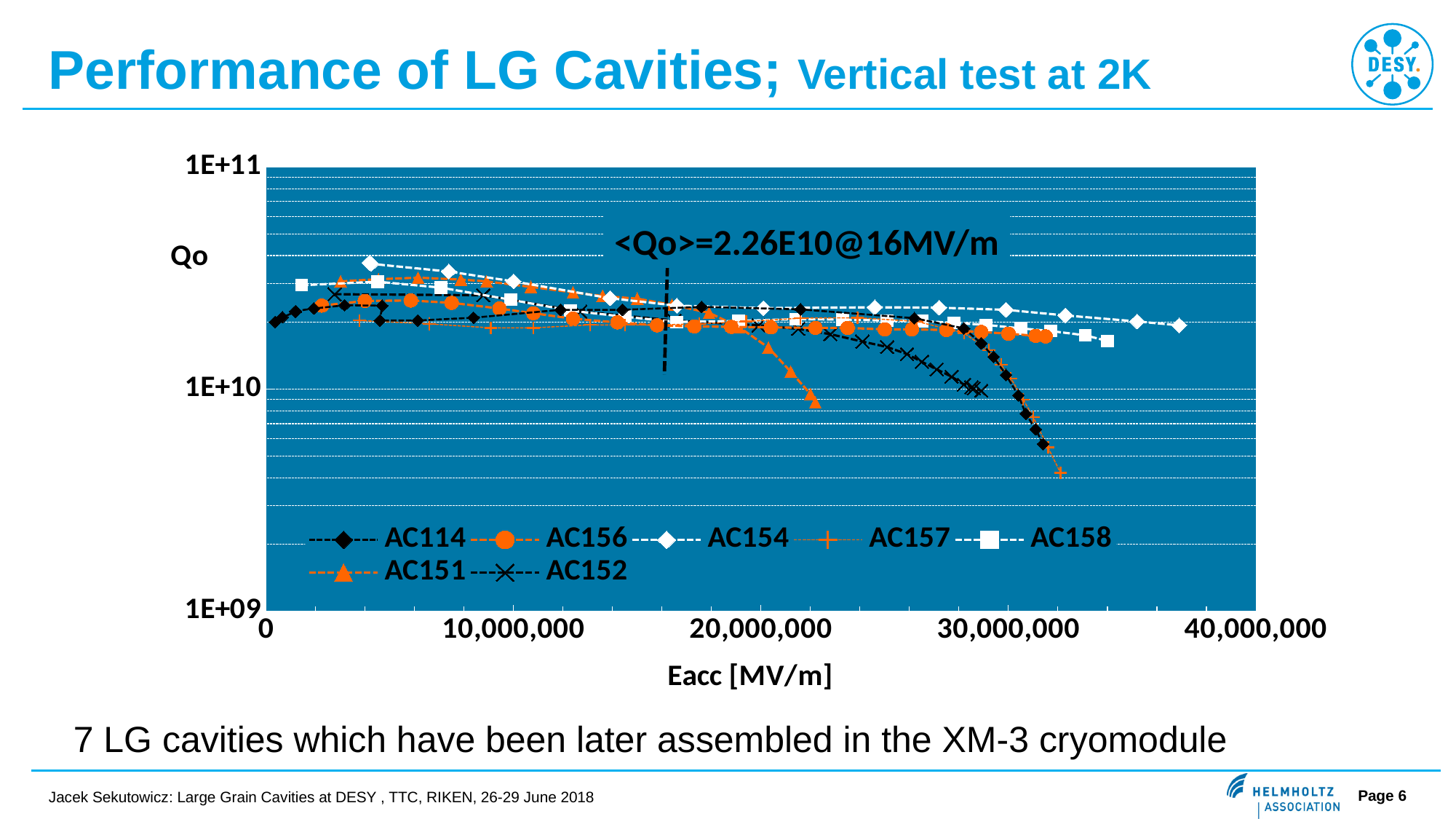
What is the label of the x axis? Eacc [MV/m] How many series does the legend list? 7 What is the lowest tick value shown on the y axis? 1E+09 Does the Qo of the AC114 series rise or fall as Eacc increases beyond 30,000,000? fall What is the label of the y axis? Qo What kind of chart is shown on the slide? Line chart Which series extends to the highest Eacc value on the x axis? AC154 What is the highest tick value shown on the y axis? 1E+11 Is the Qo value of the last point of the AC154 series greater or less than 1E+10? greater Is the Qo value of the last point of the AC157 series greater or less than 1E+10? less What is the largest tick value shown on the x axis? 40,000,000 Which series ends at the lowest Eacc value on the x axis? AC151